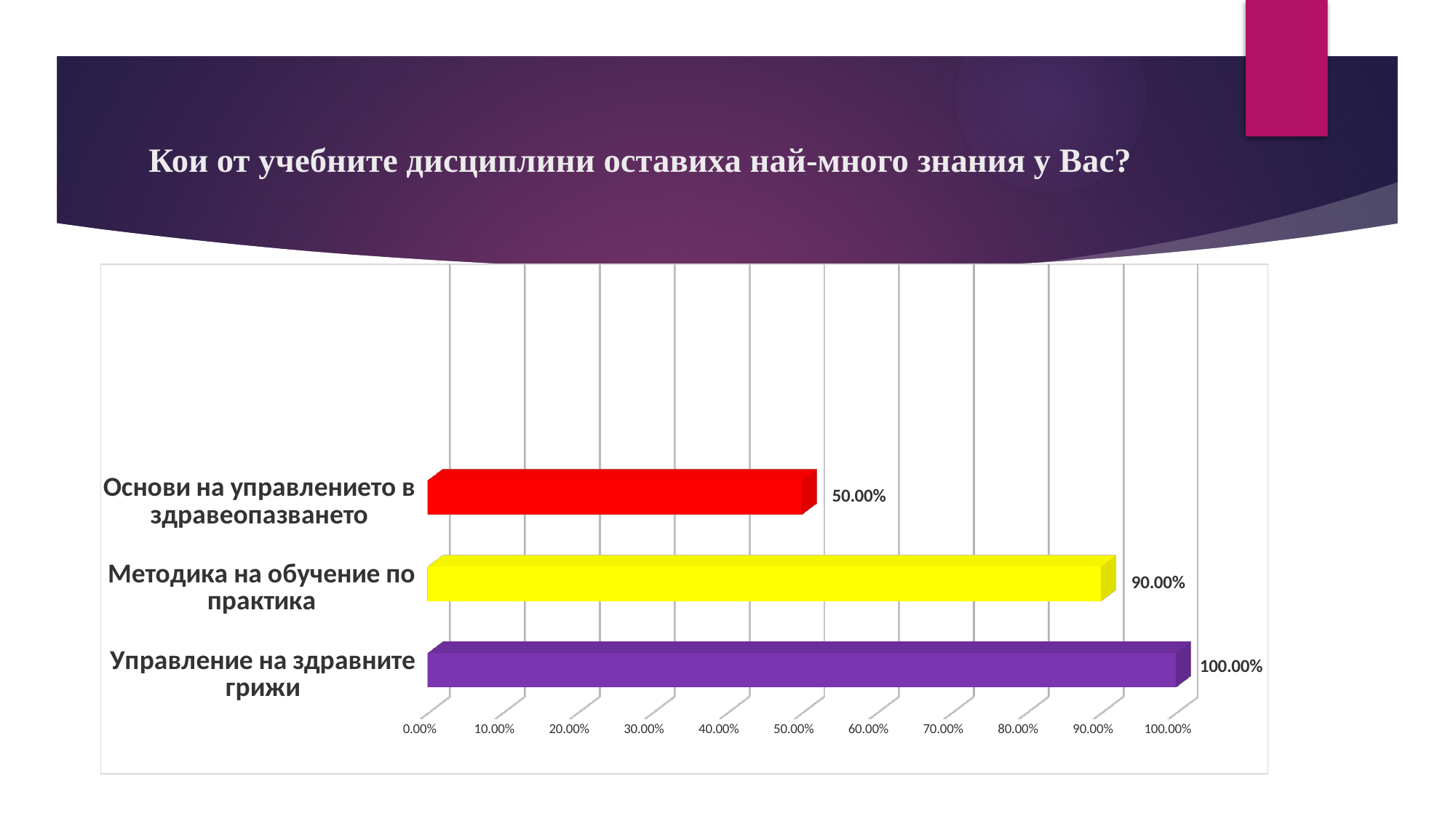
What is the value for Управление на здравните грижи? 100.00% Which category has the highest value? Управление на здравните грижи What colour is the bar for Методика на обучение по практика? Yellow What is the value for Методика на обучение по практика? 90.00% What is the value for Основи на управлението в здравеопазването? 50.00% What is the difference between the values for Методика на обучение по практика and Основи на управлението в здравеопазването? 40.00% Which category has the lowest value? Основи на управлението в здравеопазването How many categories are shown in the chart? 3 Which is larger, the value for Методика на обучение по практика or the value for Основи на управлението в здравеопазването? Методика на обучение по практика What kind of chart is shown on the slide? Bar chart What is the difference between the values for Управление на здравните грижи and Основи на управлението в здравеопазването? 50.00% Is the value for Методика на обучение по практика greater or less than 80.00%? greater